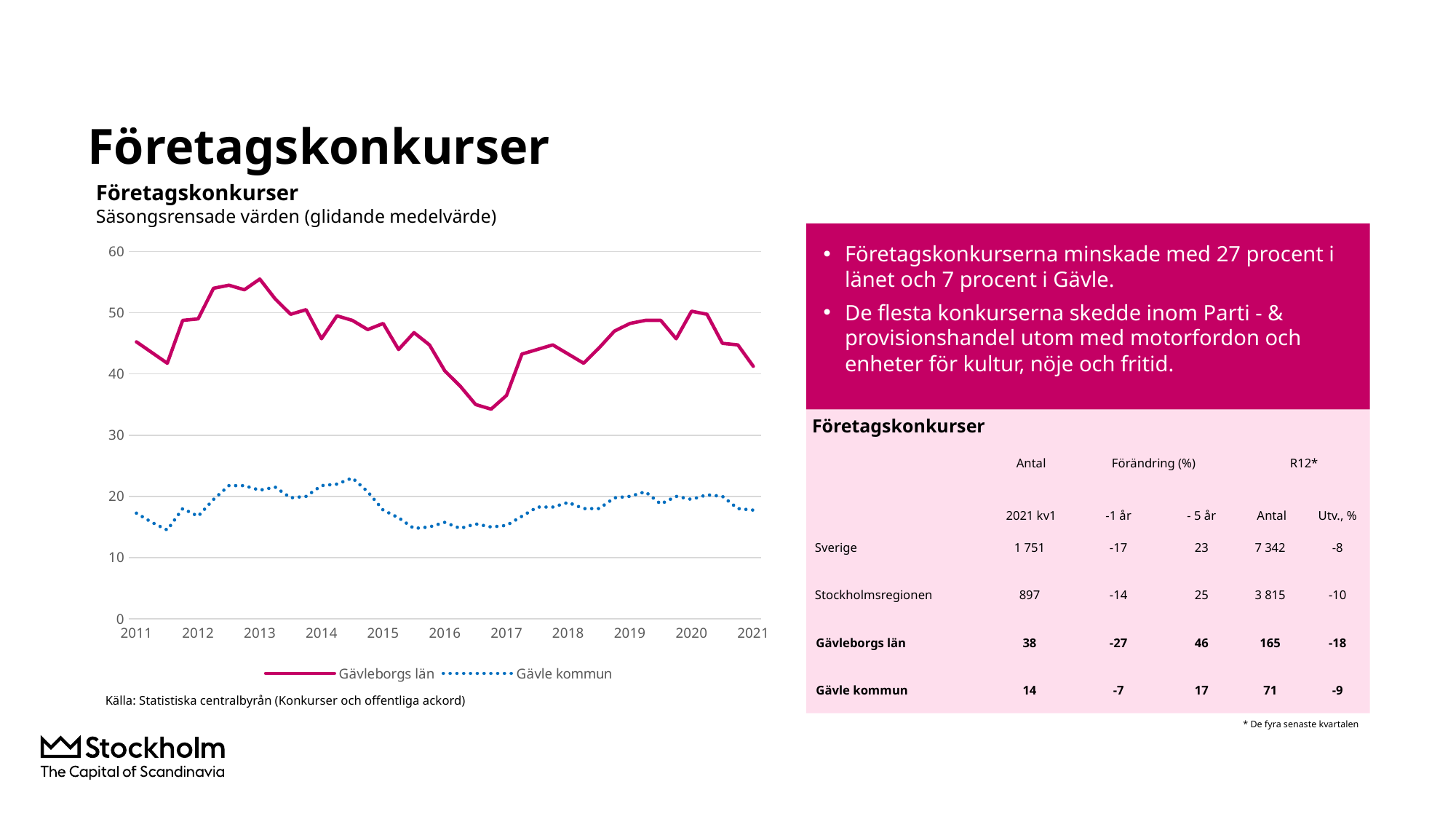
How many series does the chart legend list? 2 What kind of chart is shown on the slide? line chart Is the value for Gävle kommun at the start of 2011 greater or less than 20? less Does the Gävleborgs län line rise or fall between 2013 and 2017? fall At 2015, which series has the higher value, Gävleborgs län or Gävle kommun? Gävleborgs län Is the value for Gävleborgs län at the start of 2017 greater or less than 40? less How many year labels are shown on the x axis of the chart? 11 Which two series are shown in the chart legend? Gävleborgs län and Gävle kommun Is the value for Gävleborgs län at the start of 2011 greater or less than 40? greater What is the subtitle of the chart, shown under 'Företagskonkurser'? Säsongsrensade värden (glidande medelvärde)